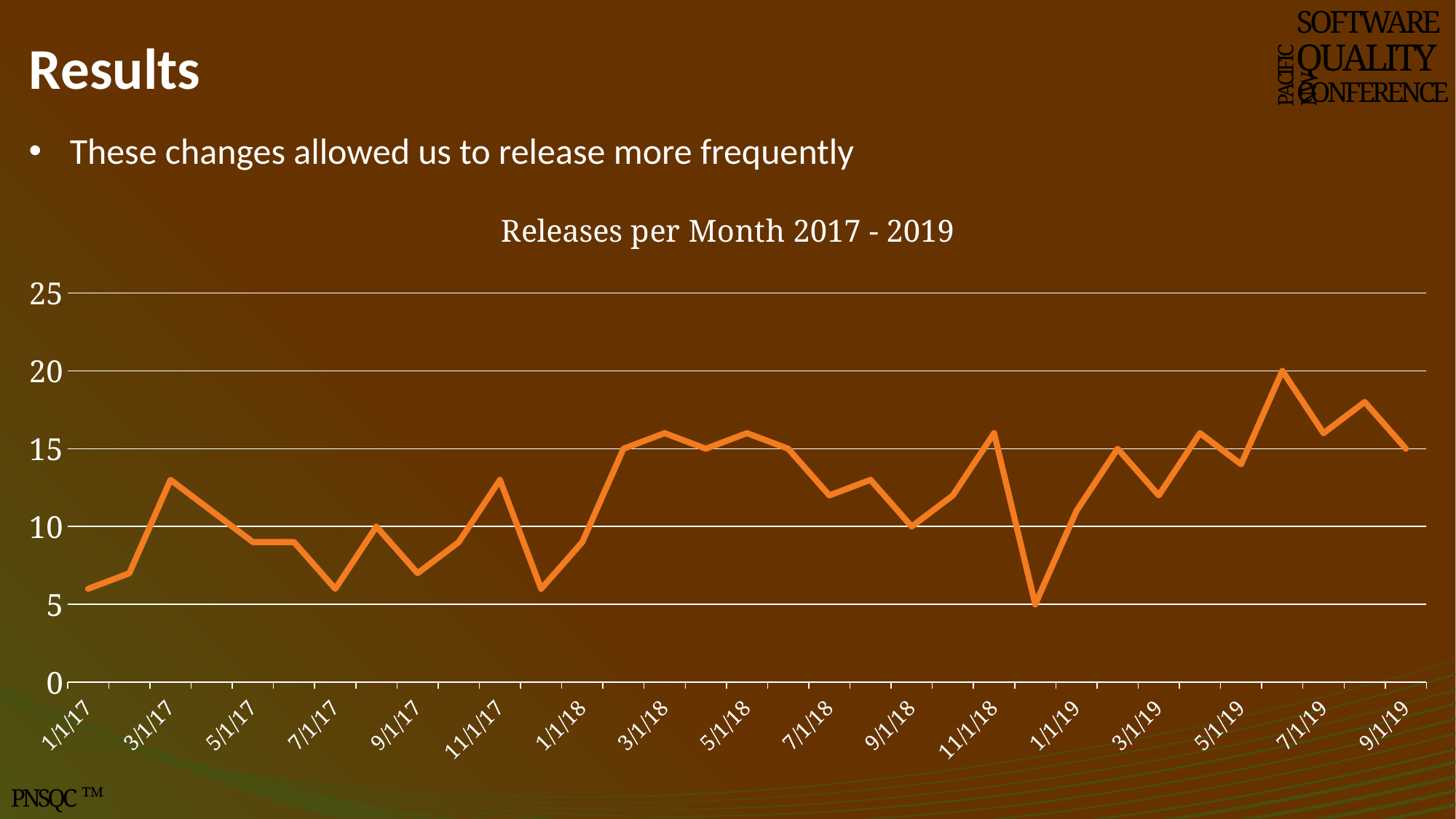
Overall, do releases per month rise or fall from 2017 to 2019? Rise Is the value for 3/1/18 greater or less than 15? greater What is the value for 9/1/18? 10 What kind of chart is shown on the slide? Line chart Is the value for 3/1/17 greater or less than 10? greater What is the title of the chart? Releases per Month 2017 - 2019 What is the value for 9/1/19? 15 What is the highest value reached by the line? 20 What is the lowest value reached by the line? 5 Is the value for 7/1/17 greater or less than 10? less Which is larger, the value for 1/1/17 or the value for 3/1/18? 3/1/18